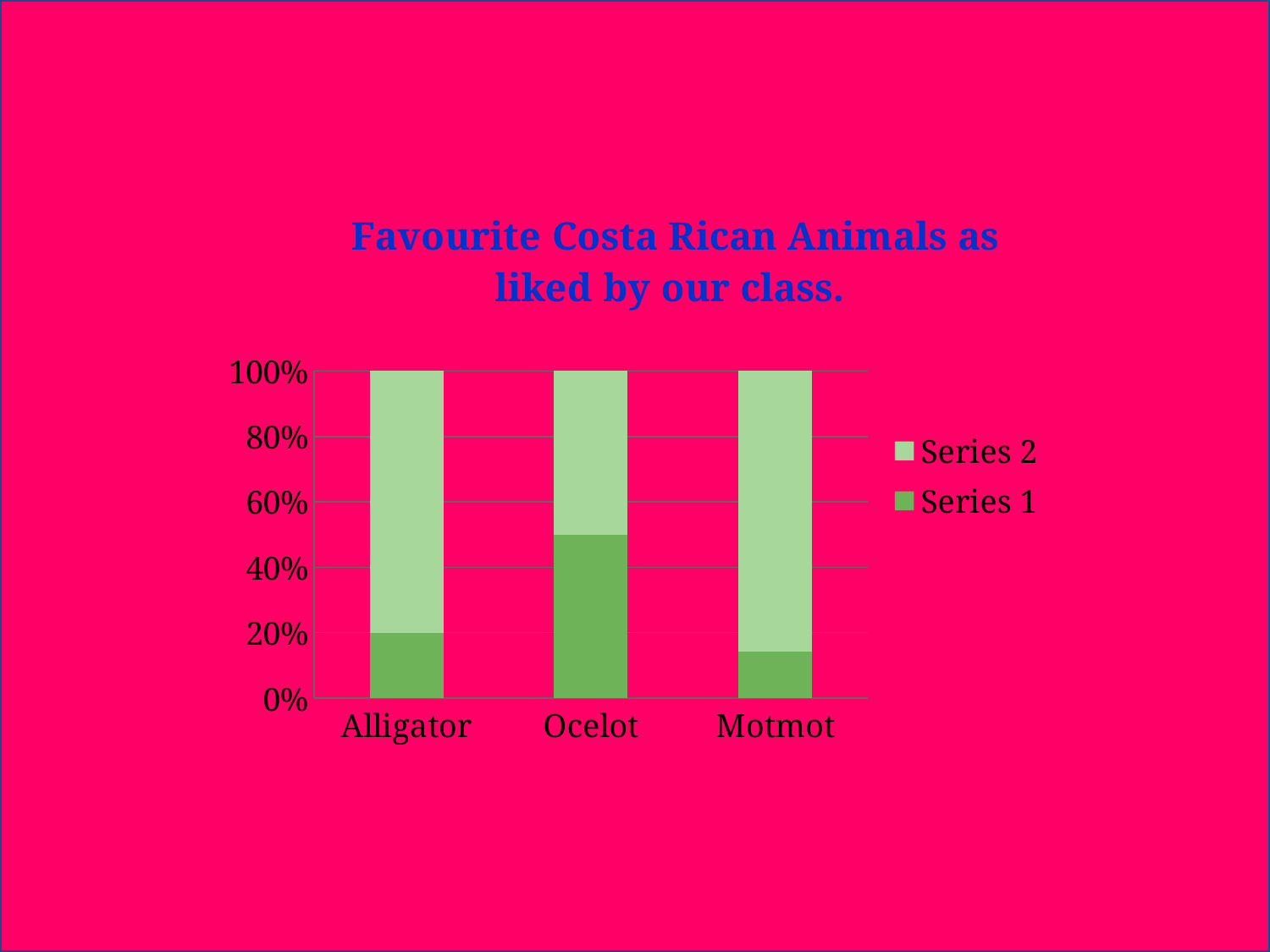
Is the Series 1 value for Alligator greater or less than 40%? less What is the title of the chart? Favourite Costa Rican Animals as liked by our class. Which has the larger Series 1 value, Alligator or Ocelot? Ocelot Is the Series 2 value for Alligator greater or less than 60%? greater Is the Series 1 value for Ocelot greater or less than 40%? greater Which animal has the smallest Series 1 share? Motmot How many animal categories are shown on the x axis? 3 What kind of chart is shown on the slide? bar chart How many series does the legend list? 2 What is the total height of the Alligator stacked bar? 100% Which animal has the largest Series 1 share? Ocelot